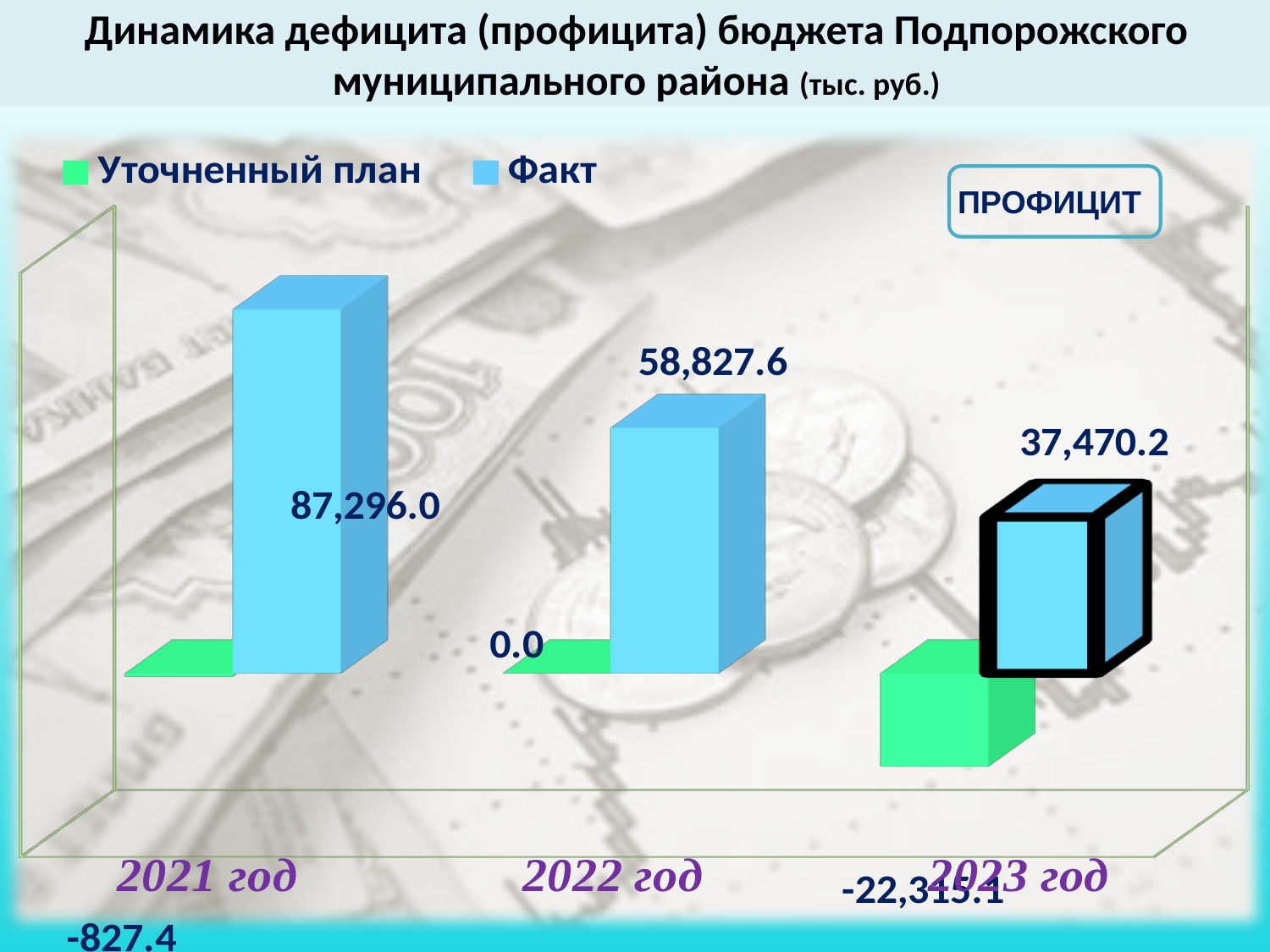
How many series does the legend list? 2 Which year has the lowest Факт value? 2023 год What is the value of Уточненный план for 2022 год? 0.0 Do the Факт values rise or fall from 2021 год to 2023 год? fall What is the value of Факт for 2021 год? 87,296.0 Which is larger, the Факт value for 2022 год or for 2023 год? 2022 год How many years are shown on the x axis? 3 Which year has the highest Факт value? 2021 год What is the difference between the Факт values for 2021 год and 2022 год? 28,468.4 What is the value of Факт for 2023 год? 37,470.2 What is the value of Уточненный план for 2021 год? -827.4 What is the value of Факт for 2022 год? 58,827.6